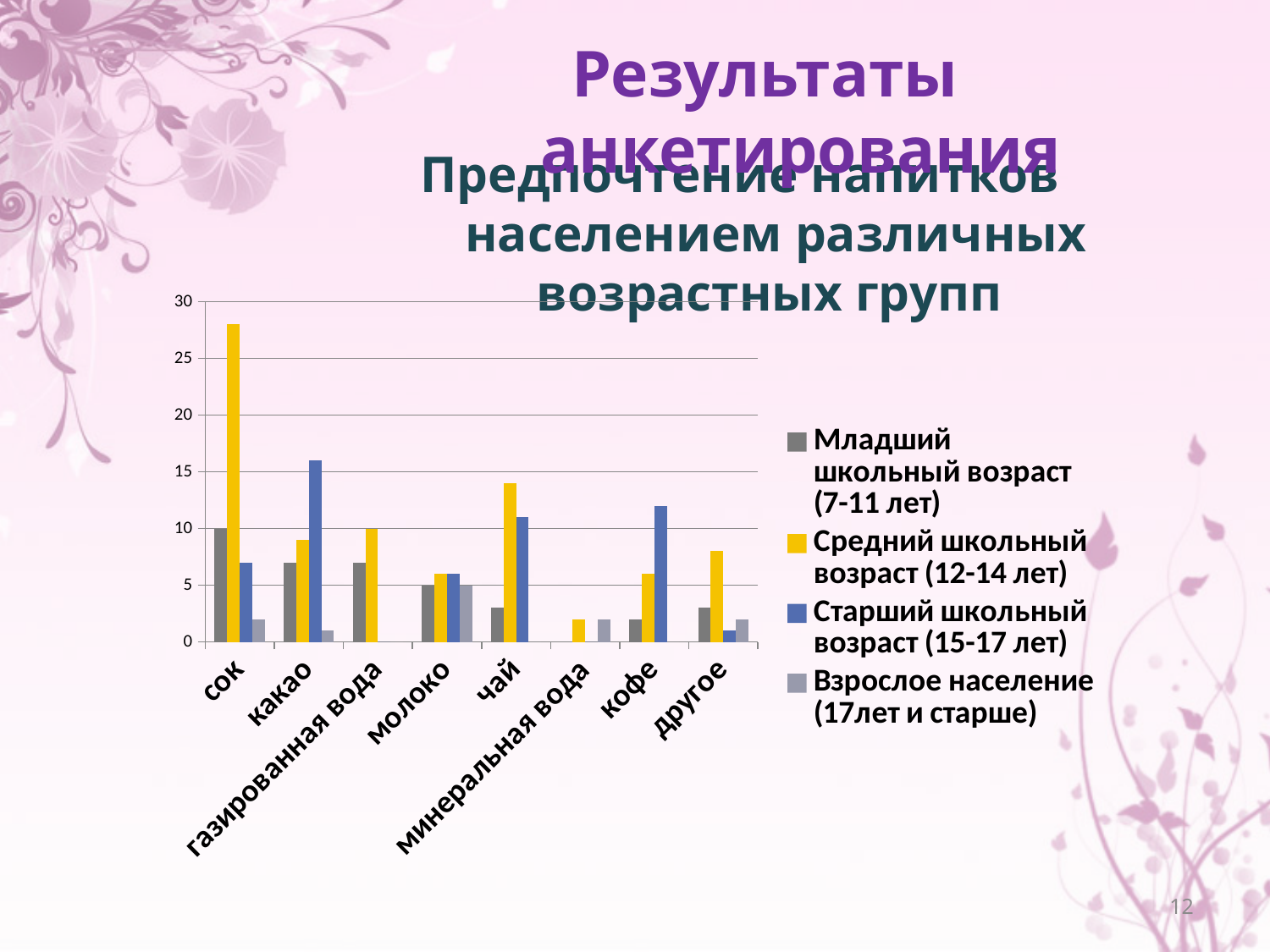
For какао, which series has the larger value: Средний школьный возраст (12-14 лет) or Старший школьный возраст (15-17 лет)? Старший школьный возраст (15-17 лет) What colour are the bars for the Средний школьный возраст (12-14 лет) series? yellow How many series does the chart legend list? 4 How many drink categories are shown on the x axis of the chart? 8 Which drink category has the highest value for the Старший школьный возраст (15-17 лет) series? какао Which drink category has the highest value for the Средний школьный возраст (12-14 лет) series? сок Is the value for сок in the Средний школьный возраст (12-14 лет) series greater or less than 25? greater Is the value for кофе in the Старший школьный возраст (15-17 лет) series greater or less than 10? greater Is the value for чай in the Средний школьный возраст (12-14 лет) series greater or less than 10? greater What kind of chart is shown on the slide? bar chart For сок, which series has the larger value: Младший школьный возраст (7-11 лет) or Средний школьный возраст (12-14 лет)? Средний школьный возраст (12-14 лет)